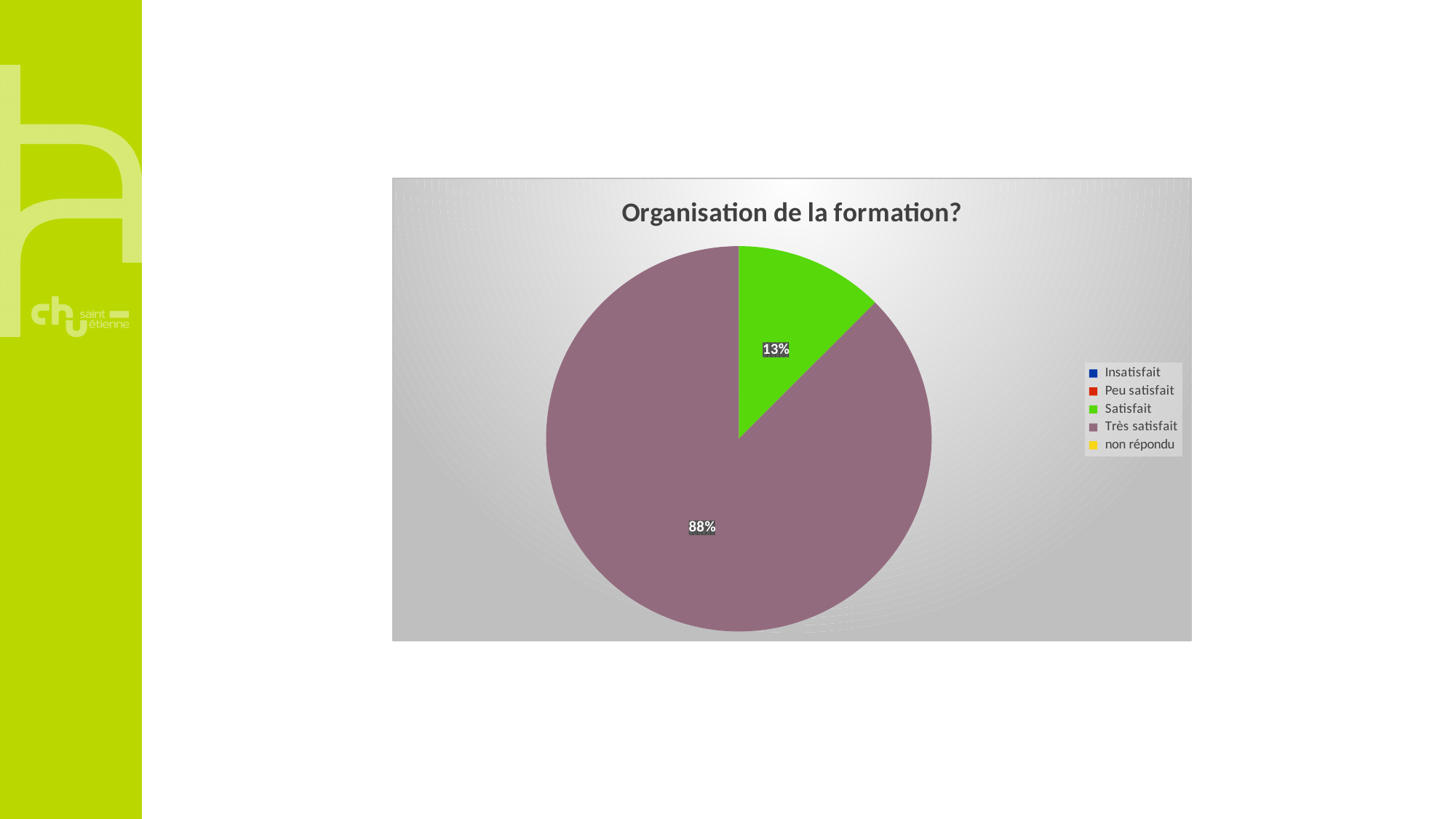
How many slices are visible in the pie? 2 Which is larger, the slice for "Satisfait" or the slice for "Très satisfait"? Très satisfait What is the difference in percentage points between the "Très satisfait" and "Satisfait" slices? 75 How many entries does the legend list? 5 Which category has the largest slice of the pie? Très satisfait What colour is the "Satisfait" slice? green What share of the pie is labelled for "Très satisfait"? 88% What kind of chart is shown on the slide? pie chart What share of the pie is labelled for "Satisfait"? 13% What is the title of the chart? Organisation de la formation?